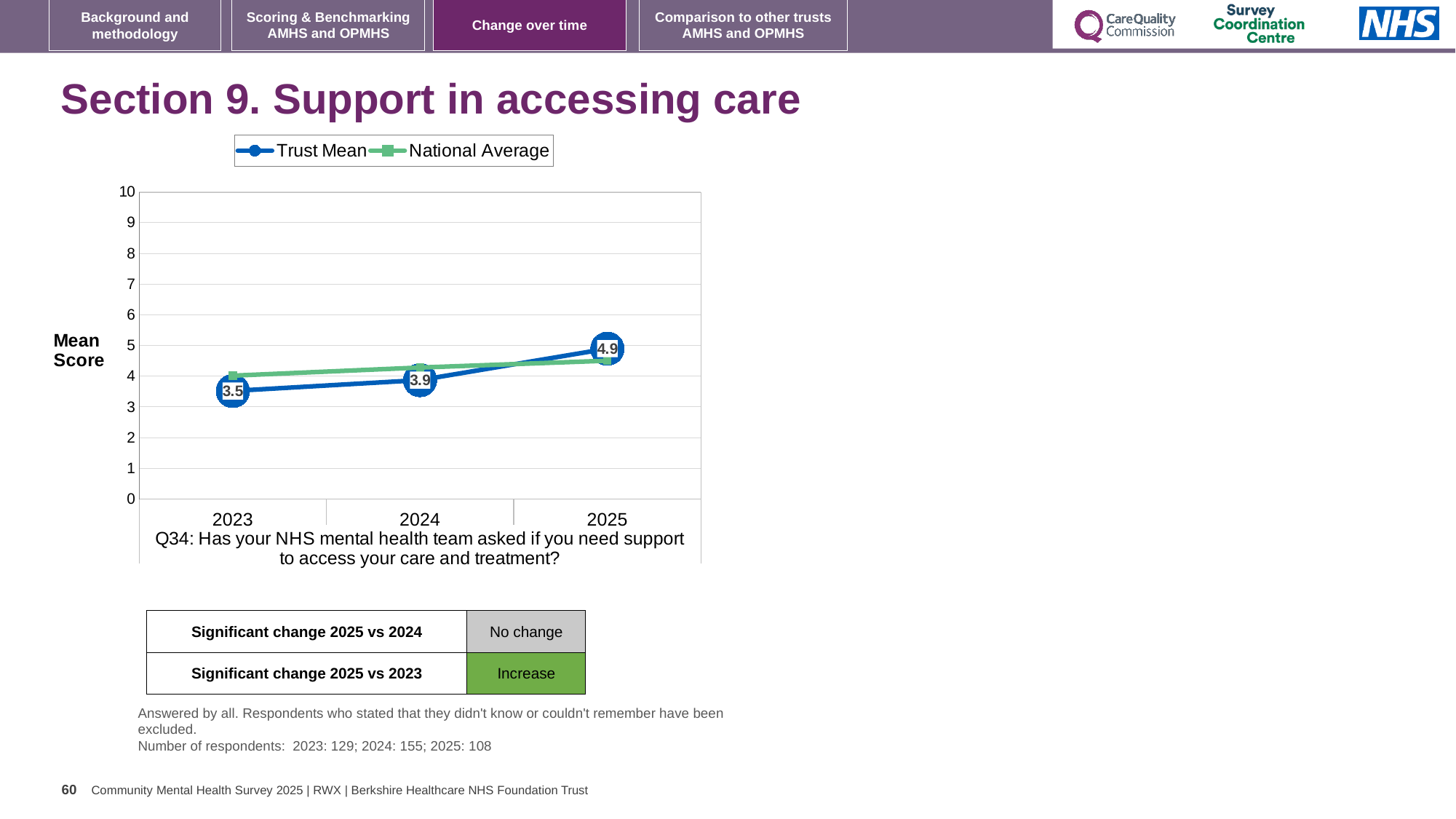
By how much did the Trust Mean change from 2023 to 2025? 1.4 How many series does the legend list? 2 Does the Trust Mean rise or fall from 2023 to 2025? rise What is the Trust Mean score for 2025? 4.9 What kind of chart is shown on the slide? line chart Which is larger in 2025, the Trust Mean or the National Average? Trust Mean In which year is the Trust Mean highest? 2025 What is the Trust Mean score for 2023? 3.5 How many years are plotted on the x axis? 3 In which year is the Trust Mean lowest? 2023 Is the National Average value for 2025 greater or less than 5? less What is the Trust Mean score for 2024? 3.9